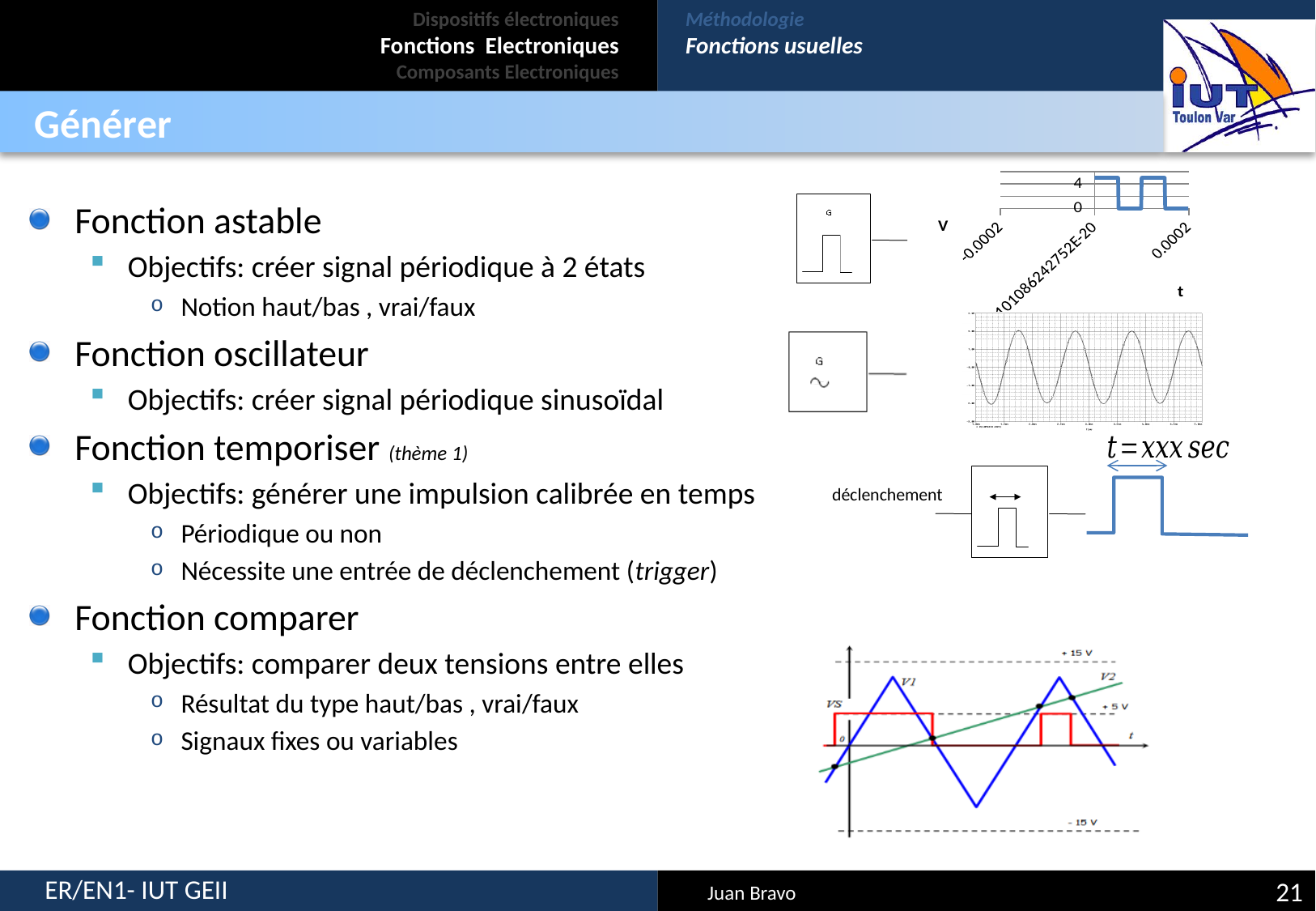
What is the label of the vertical axis of the top-right chart? V In the top-right chart with axes V and t, what is the lowest value the plotted signal reaches on the vertical axis? 0 What is the label of the horizontal axis of the top-right chart? t What type of chart is the small chart at the top right of the slide (with axes V and t)? line chart